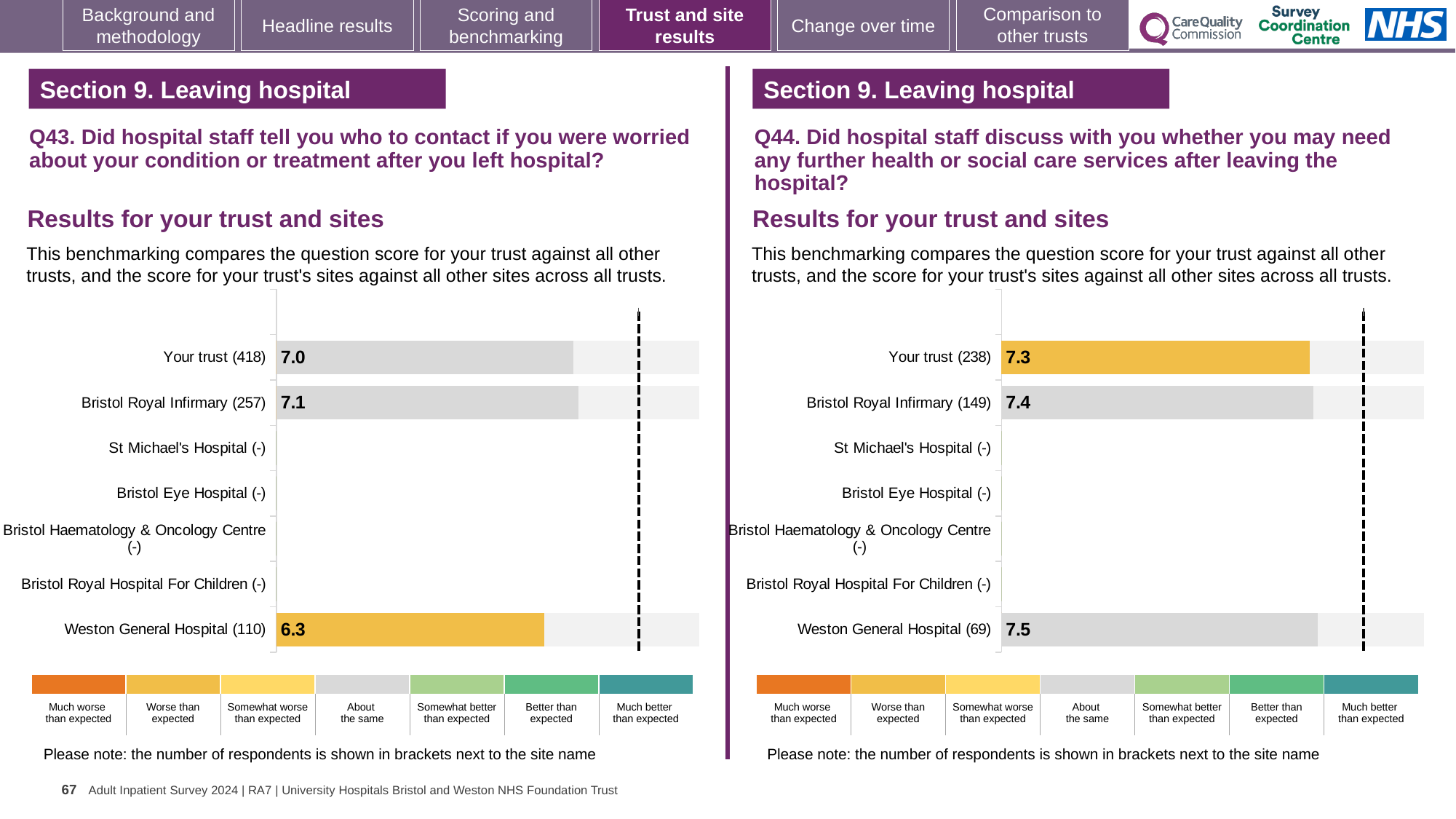
In the Q43 chart on the left, what is the difference between the Bristol Royal Infirmary score and the Weston General Hospital score? 0.8 In the Q44 chart on the right, which site or trust has the highest score shown? Weston General Hospital In the Q43 chart on the left, which site or trust has the lowest score shown? Weston General Hospital In the Q44 chart on the right, what is the difference between the Weston General Hospital score and the Your trust score? 0.2 In the Q44 chart on the right, what is the score for Bristol Royal Infirmary? 7.4 In the Q43 chart on the left, what colour is the bar for Weston General Hospital? Orange/yellow (Worse than expected) In the Q43 chart on the left, what is the score for Your trust? 7.0 In the Q43 chart on the left, what is the score for Weston General Hospital? 6.3 What kind of chart is used for the Q43 results on the left? Bar chart In the Q43 chart on the left, which has the larger score: Your trust or Weston General Hospital? Your trust In the Q44 chart on the right, what is the score for Weston General Hospital? 7.5 How many site or trust categories are listed on the y axis of the Q44 chart on the right? 7